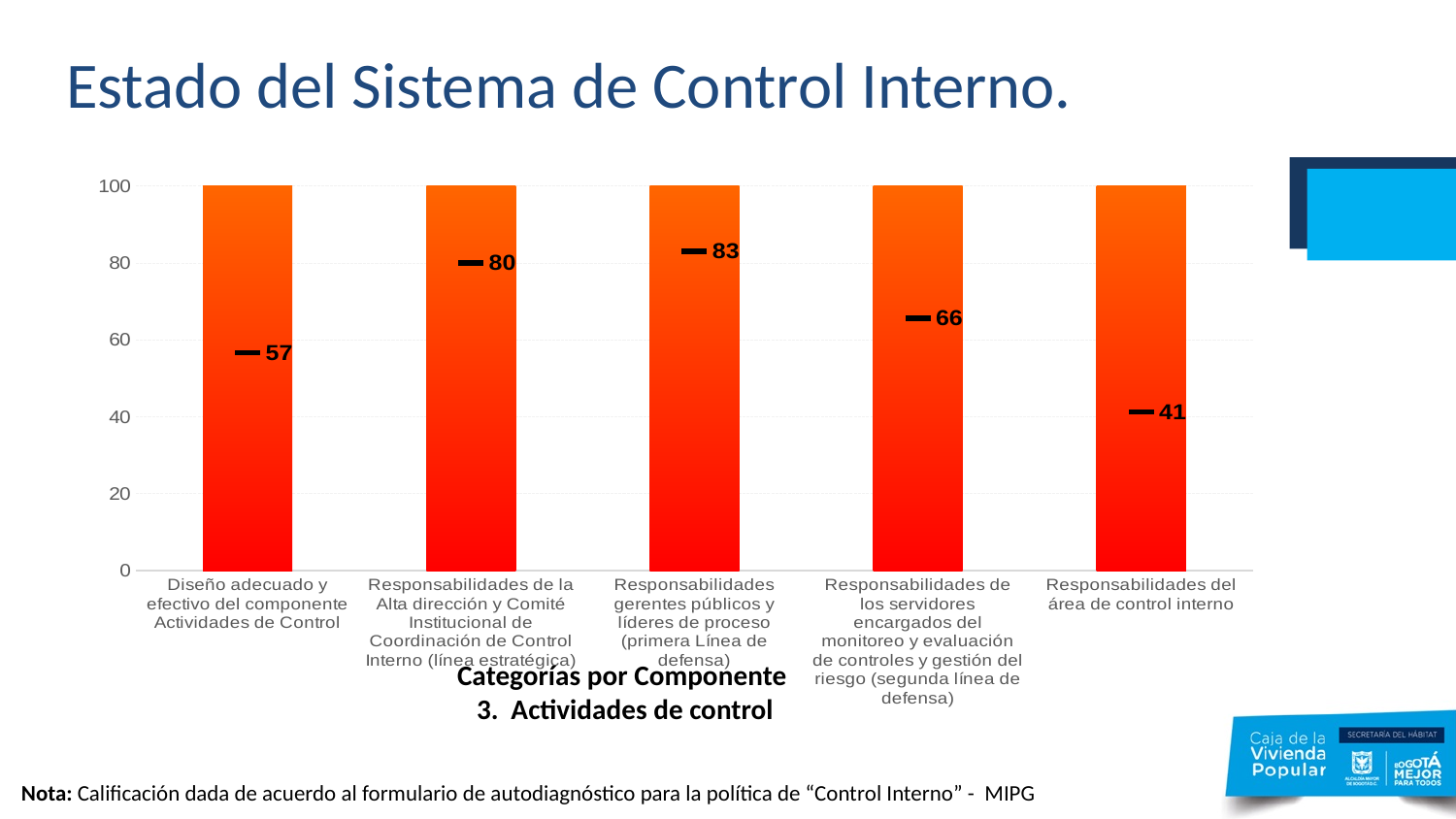
Which category has the highest labelled value? Responsabilidades gerentes públicos y líderes de proceso (primera Línea de defensa) What is the difference between the value for "Responsabilidades de la Alta dirección y Comité Institucional de Coordinación de Control Interno (línea estratégica)" and the value for "Diseño adecuado y efectivo del componente Actividades de Control"? 23 What value is shown for "Responsabilidades del área de control interno"? 41 Which category has the lowest labelled value? Responsabilidades del área de control interno What value is shown for "Diseño adecuado y efectivo del componente Actividades de Control"? 57 How many categories are shown on the x axis of the chart? 5 Which is larger: the value for "Responsabilidades de los servidores encargados del monitoreo y evaluación de controles y gestión del riesgo (segunda línea de defensa)" or the value for "Responsabilidades del área de control interno"? Responsabilidades de los servidores encargados del monitoreo y evaluación de controles y gestión del riesgo (segunda línea de defensa) What is the title of the slide? Estado del Sistema de Control Interno. What kind of chart is shown on the slide? bar chart What value is shown for "Responsabilidades de los servidores encargados del monitoreo y evaluación de controles y gestión del riesgo (segunda línea de defensa)"? 66 What value is shown for "Responsabilidades gerentes públicos y líderes de proceso (primera Línea de defensa)"? 83 Is the labelled value for "Responsabilidades de la Alta dirección y Comité Institucional de Coordinación de Control Interno (línea estratégica)" greater or less than 60? greater